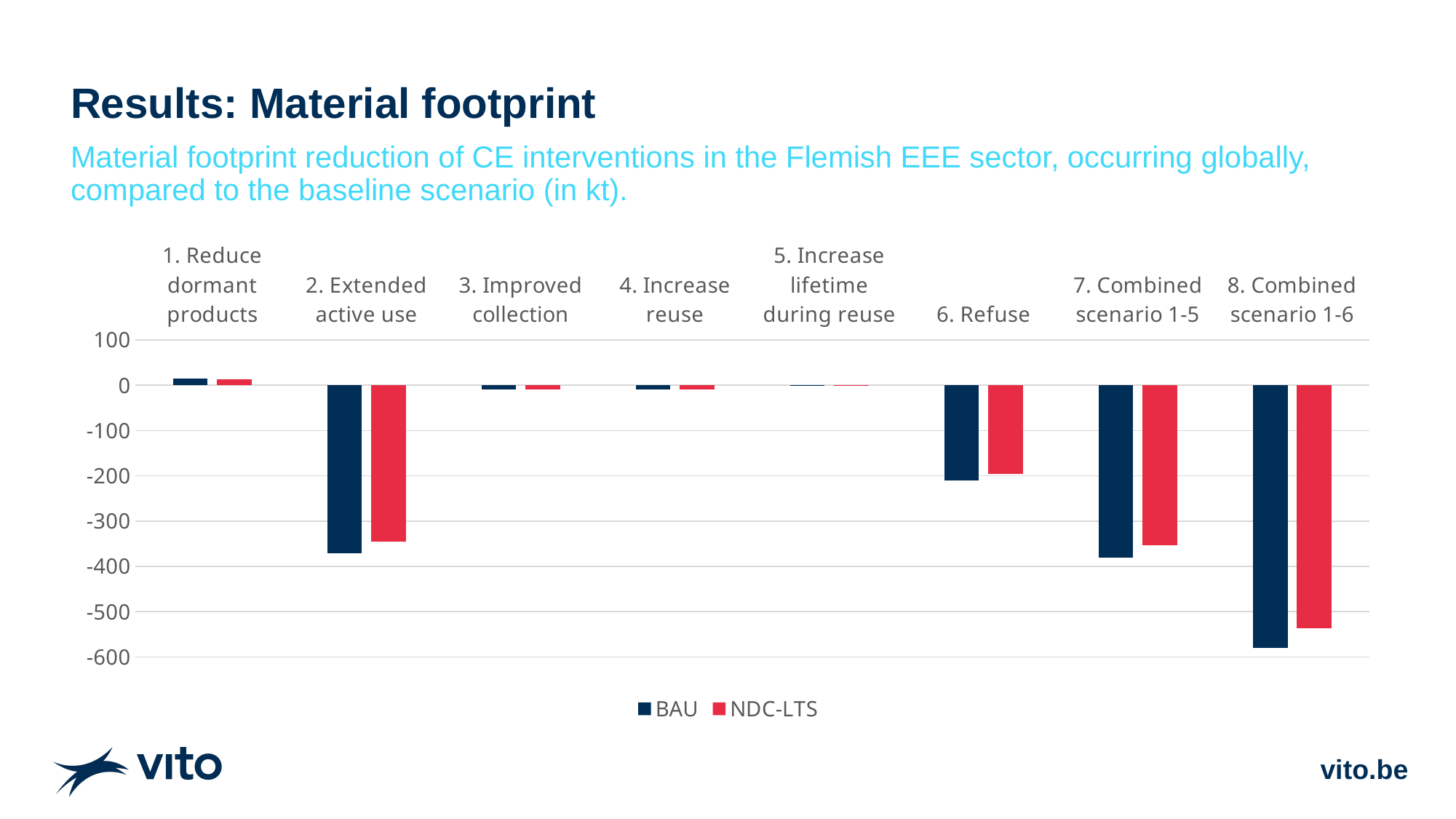
How many series does the legend list? 2 Is the NDC-LTS value for 6. Refuse greater or less than -100? less Is the BAU value for 2. Extended active use greater or less than -300? less How many intervention categories are shown on the x axis? 8 For 8. Combined scenario 1-6, which series has the larger (less negative) value, BAU or NDC-LTS? NDC-LTS Which category has the lowest (most negative) BAU value? 8. Combined scenario 1-6 What kind of chart is shown on the slide? Bar chart Is the BAU value for 8. Combined scenario 1-6 greater or less than -500? less What unit does the subtitle say the material footprint reduction is expressed in? kt Which category has the highest NDC-LTS value? 1. Reduce dormant products Which series is shown in red in the legend? NDC-LTS